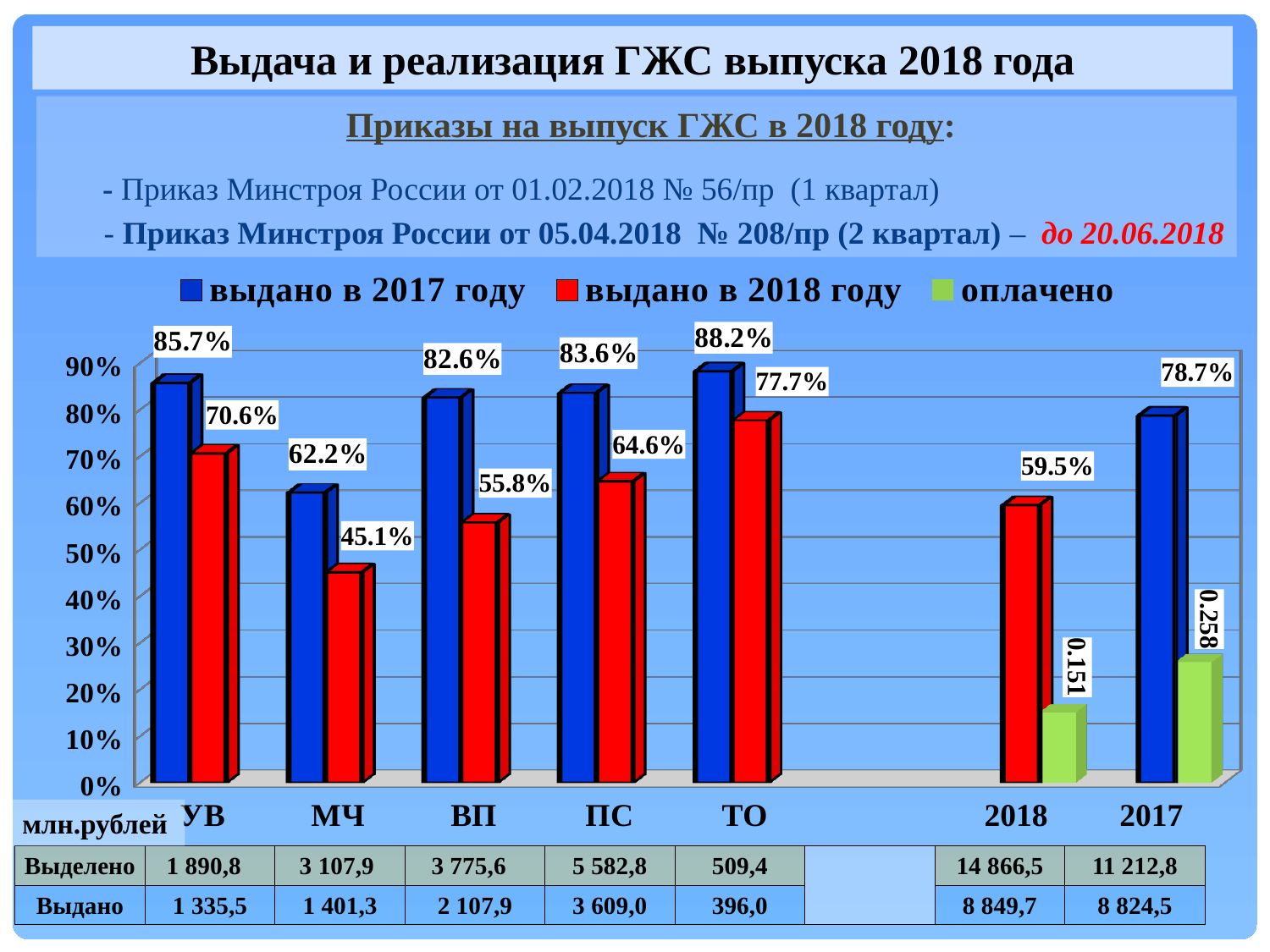
What colour are the bars for the series 'оплачено'? green Which category has the highest value in the series 'выдано в 2017 году'? ТО How many series does the legend list? 3 How many categories are shown on the x axis of the chart? 7 Which category has the lowest value in the series 'выдано в 2018 году'? МЧ What is the value for УВ in the series 'выдано в 2017 году'? 85.7% Which is larger: the 'выдано в 2018 году' value for ПС or for УВ? УВ What is the value for ТО in the series 'выдано в 2018 году'? 77.7% What kind of chart is shown on the slide? bar chart What is the 'оплачено' value for the 2017 category? 0.258 What is the difference between the 'выдано в 2017 году' and 'выдано в 2018 году' values for ВП? 26.8% What is the value for МЧ in the series 'выдано в 2018 году'? 45.1%